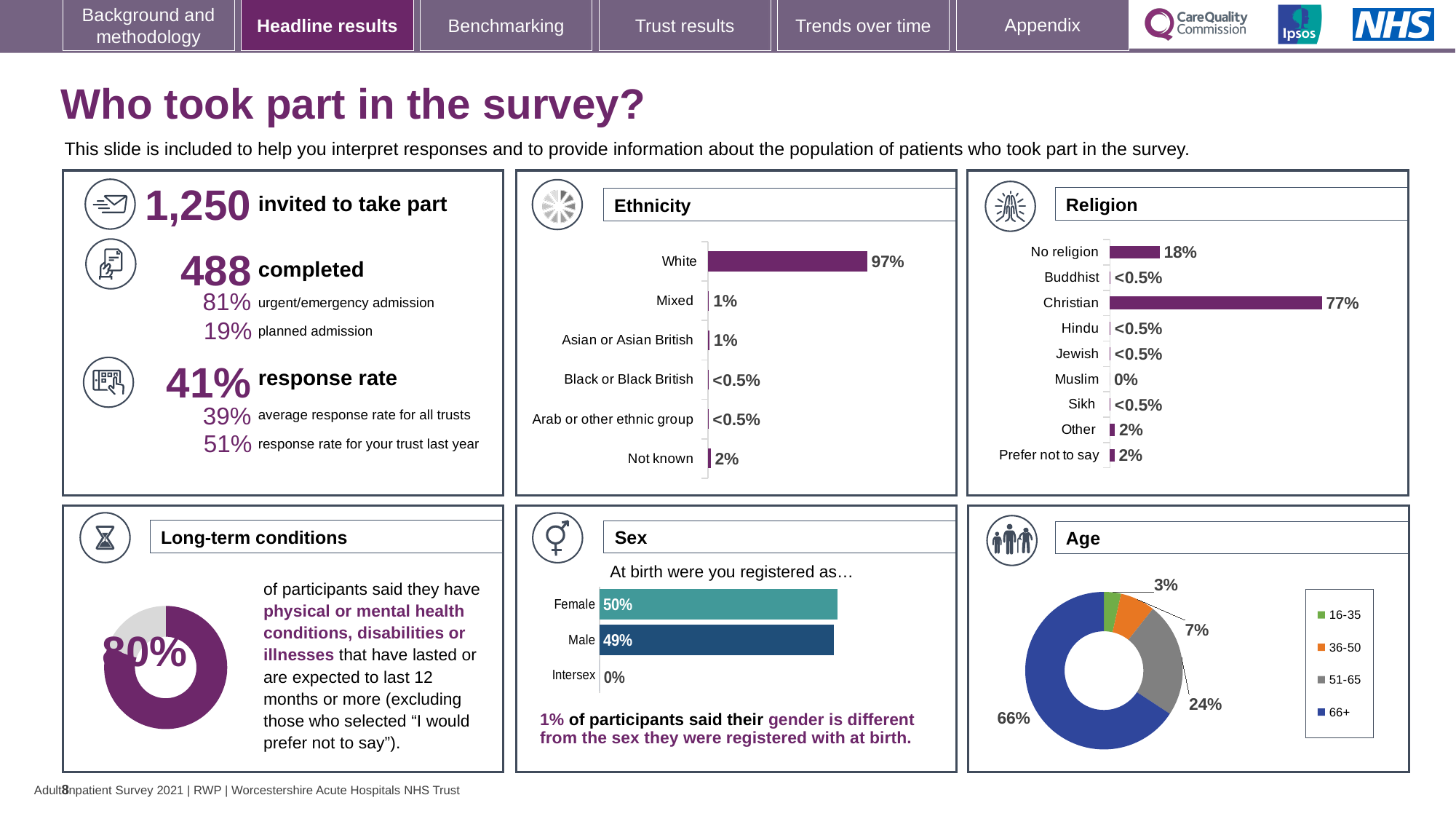
In the Religion chart, what is the value for No religion? 18% In the Religion chart, which religion category has the highest value? Christian In the Ethnicity chart, how many ethnic group categories are shown? 6 In the Religion chart, how many categories are listed? 9 In the Age chart, what share of participants were aged 66+? 66% In the Ethnicity chart, what is the value for Not known? 2% In the Age chart, how many age groups does the legend list? 4 In the Religion chart, what is the difference between the Christian and No religion values? 59% In the Sex chart, which is larger, the Female value or the Male value? Female What kind of chart is used in the Age panel? Donut chart In the Ethnicity chart, what percentage of participants were White? 97% In the Sex chart, what percentage of participants were registered as Male at birth? 49%